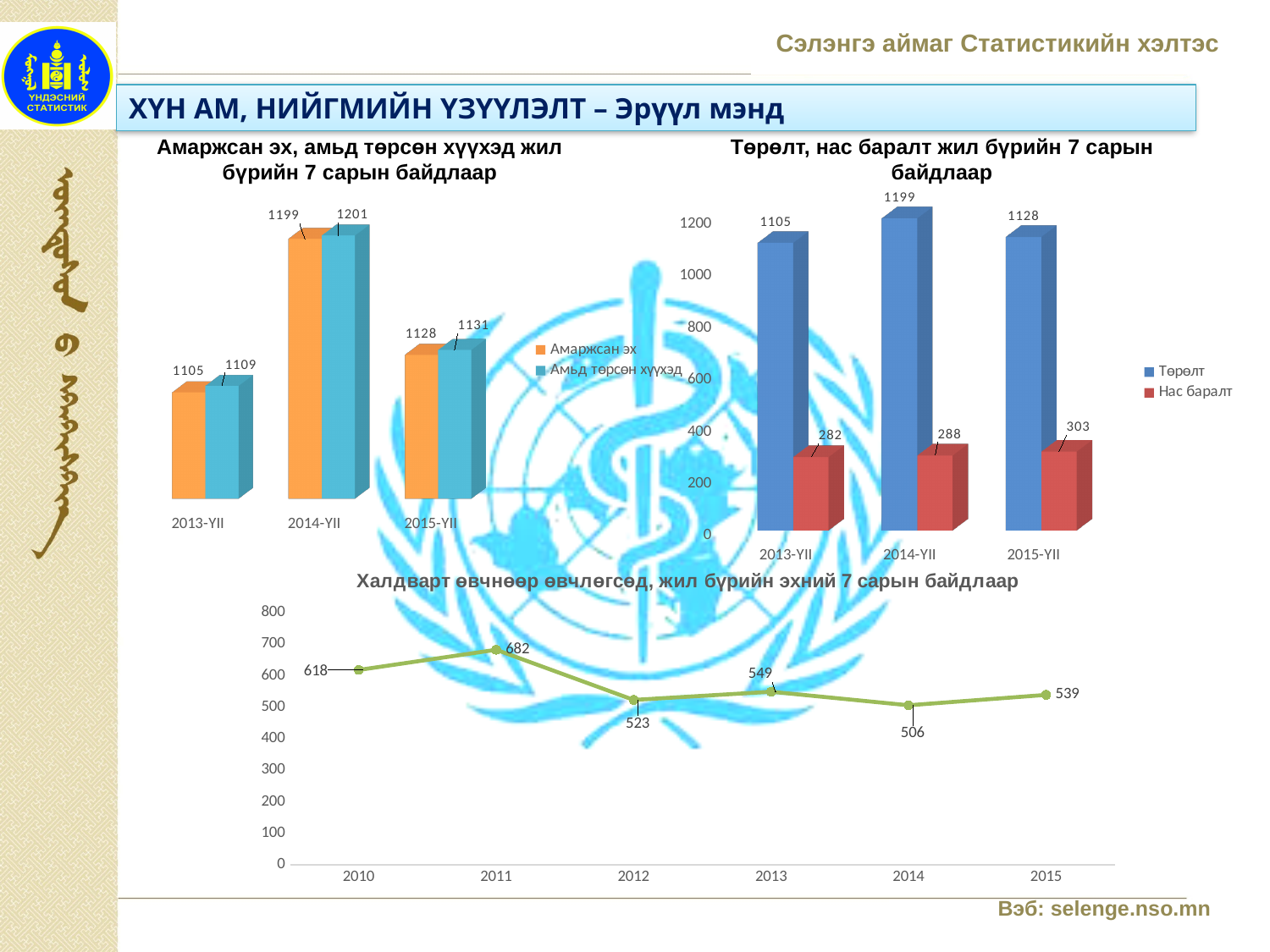
In the chart titled 'Халдварт өвчнөөр өвчлөгсөд, жил бүрийн эхний 7 сарын байдлаар', which year has the highest value? 2011 In the chart titled 'Төрөлт, нас баралт жил бүрийн 7 сарын байдлаар', what is the value for Нас баралт in 2015-YII? 303 In the chart titled 'Төрөлт, нас баралт жил бүрийн 7 сарын байдлаар', what kind of chart is it? bar chart In the chart titled 'Амаржсан эх, амьд төрсөн хүүхэд жил бүрийн 7 сарын байдлаар', what is the value for Амаржсан эх in 2014-YII? 1199 In the chart titled 'Халдварт өвчнөөр өвчлөгсөд, жил бүрийн эхний 7 сарын байдлаар', what is the value for 2012? 523 In the chart titled 'Халдварт өвчнөөр өвчлөгсөд, жил бүрийн эхний 7 сарын байдлаар', how many years are plotted? 6 In the chart titled 'Амаржсан эх, амьд төрсөн хүүхэд жил бүрийн 7 сарын байдлаар', what is the value for Амьд төрсөн хүүхэд in 2015-YII? 1131 In the chart titled 'Төрөлт, нас баралт жил бүрийн 7 сарын байдлаар', what is the difference between Төрөлт and Нас баралт in 2013-YII? 823 In the chart titled 'Амаржсан эх, амьд төрсөн хүүхэд жил бүрийн 7 сарын байдлаар', which year has the lowest value for Амаржсан эх? 2013-YII In the chart titled 'Төрөлт, нас баралт жил бүрийн 7 сарын байдлаар', which year has the highest value for Төрөлт? 2014-YII In the chart titled 'Амаржсан эх, амьд төрсөн хүүхэд жил бүрийн 7 сарын байдлаар', how many series does the legend list? 2 In the chart titled 'Халдварт өвчнөөр өвчлөгсөд, жил бүрийн эхний 7 сарын байдлаар', is the value for 2014 larger or smaller than the value for 2015? smaller